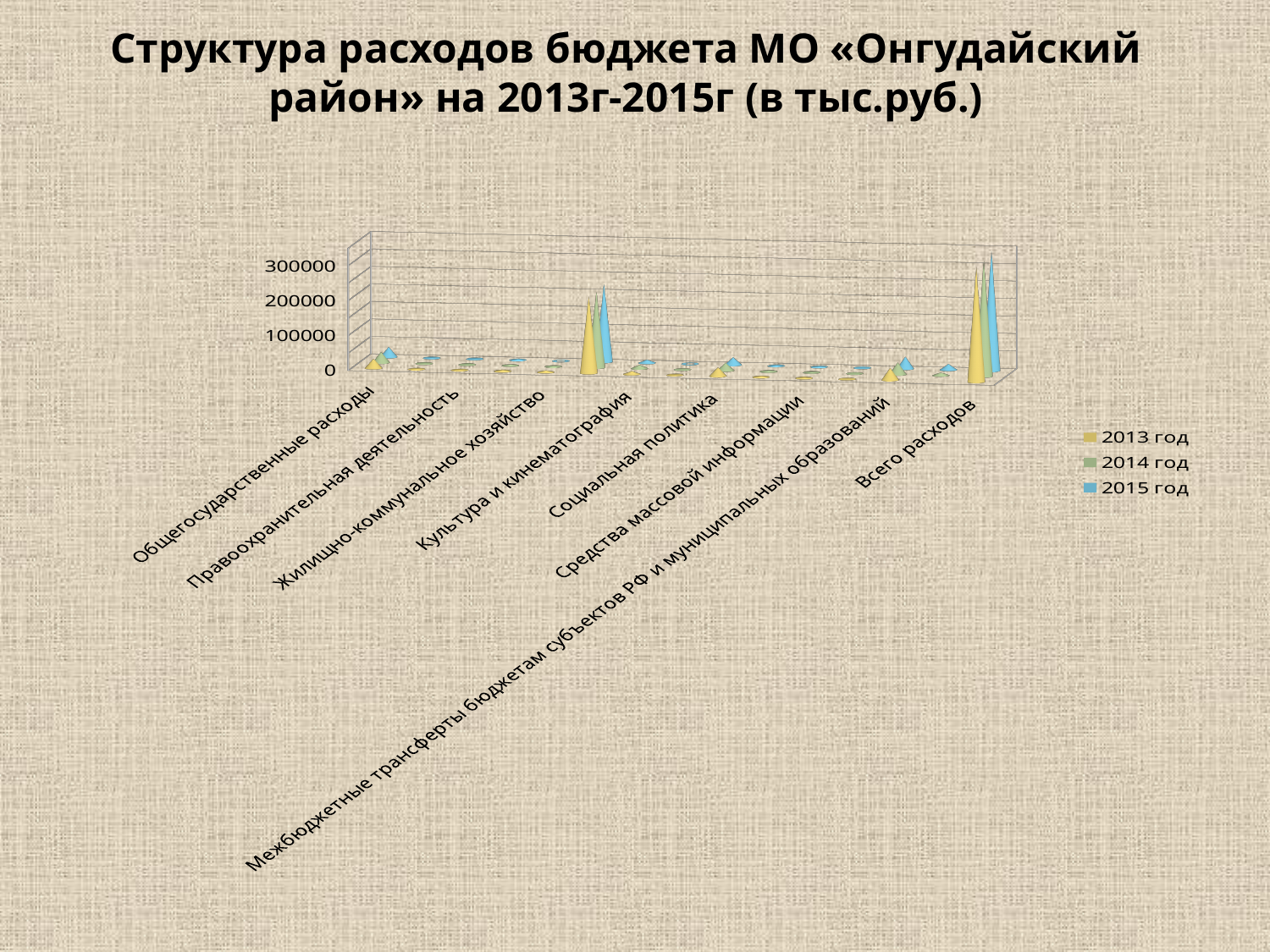
What is the title of the slide containing the chart? Структура расходов бюджета МО «Онгудайский район» на 2013г-2015г (в тыс.руб.) Which is larger in 2015 год: Всего расходов or Культура и кинематография? Всего расходов Which category has the highest values in the chart? Всего расходов How many series does the chart legend list? 3 Which is larger in 2013 год: Культура и кинематография or Правоохранительная деятельность? Культура и кинематография What kind of chart is shown on the slide? bar chart Which series are listed in the chart legend? 2013 год, 2014 год, 2015 год Is the value for Социальная политика in 2015 год greater or less than 100000? less Is the value for Общегосударственные расходы in 2013 год greater or less than 100000? less Is the value for Культура и кинематография in 2013 год greater or less than 300000? less